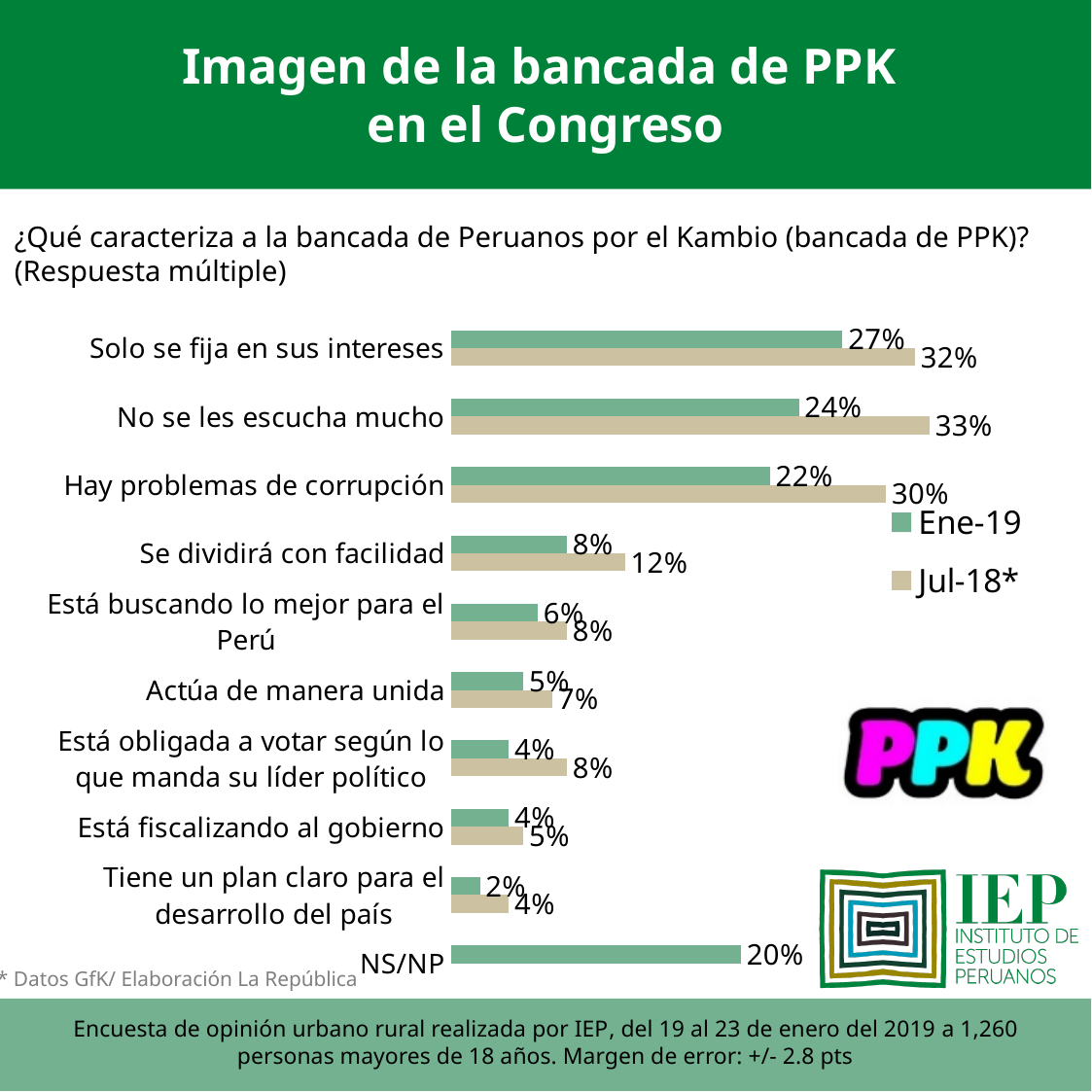
Which category has the lowest Ene-19 value? Tiene un plan claro para el desarrollo del país Which colour represents the Jul-18* series in the chart? Tan (beige) What is the Ene-19 value for "Solo se fija en sus intereses"? 27% What is the Jul-18* value for "No se les escucha mucho"? 33% What is the difference between the Jul-18* and Ene-19 values for "Hay problemas de corrupción"? 8 percentage points What is the Ene-19 value for "Hay problemas de corrupción"? 22% How many categories are shown in the chart? 10 Which is larger for "Se dividirá con facilidad": the Ene-19 value or the Jul-18* value? Jul-18* Which category has the highest Jul-18* value? No se les escucha mucho What is the Ene-19 value for NS/NP? 20% What kind of chart is shown on the slide? Bar chart How many series does the legend list? 2